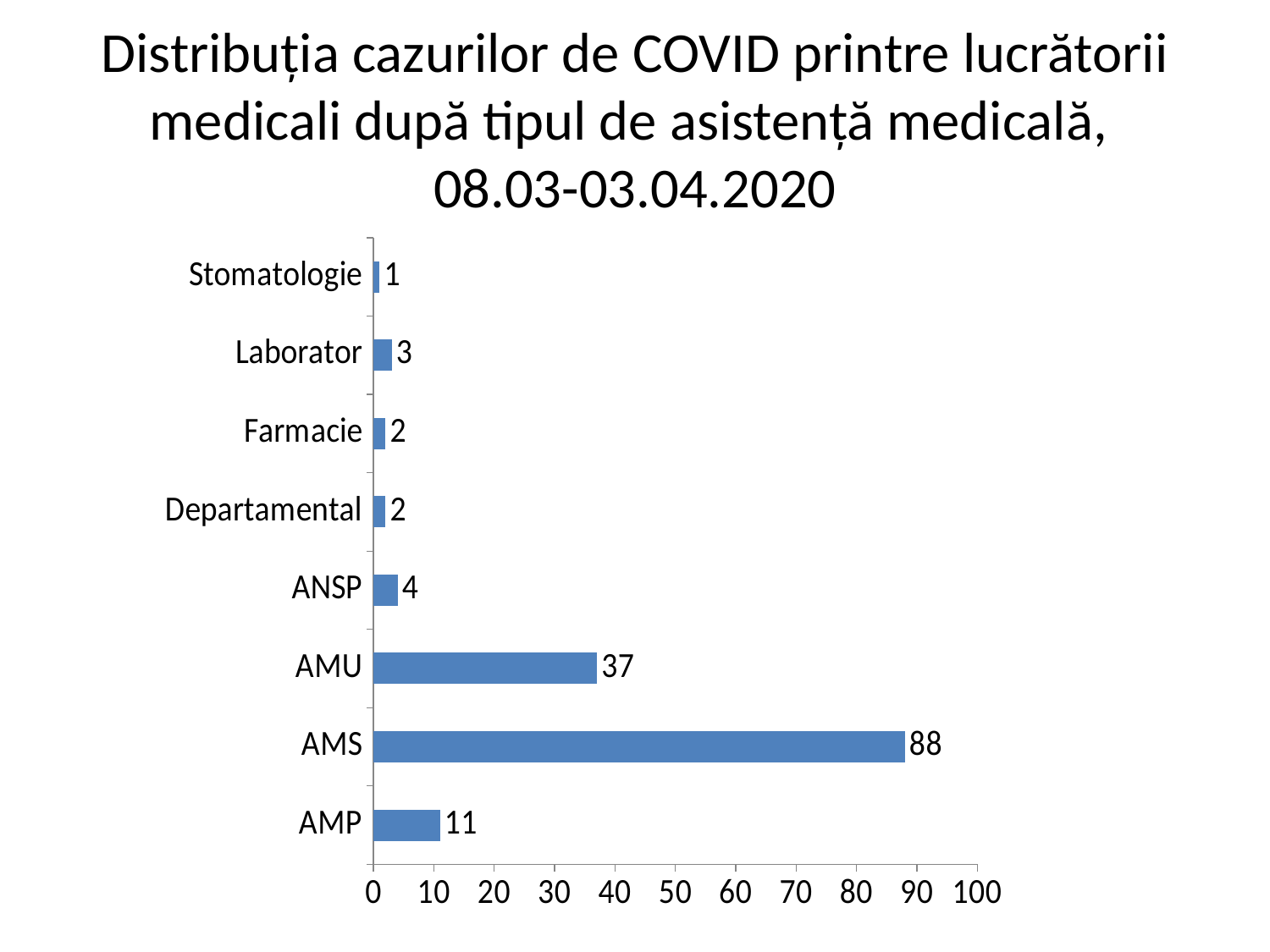
What is the value for Laborator? 3 Which is larger, the value for AMP or the value for ANSP? AMP What is the value for AMU? 37 What is the difference between the values for AMS and AMU? 51 Which category has the lowest value? Stomatologie What is the value for ANSP? 4 What is the value for AMP? 11 Which category has the highest value? AMS What is the value for AMS? 88 What kind of chart is shown on the slide? Bar chart How many categories are shown in the chart? 8 Is the value for AMS greater or less than 80? greater